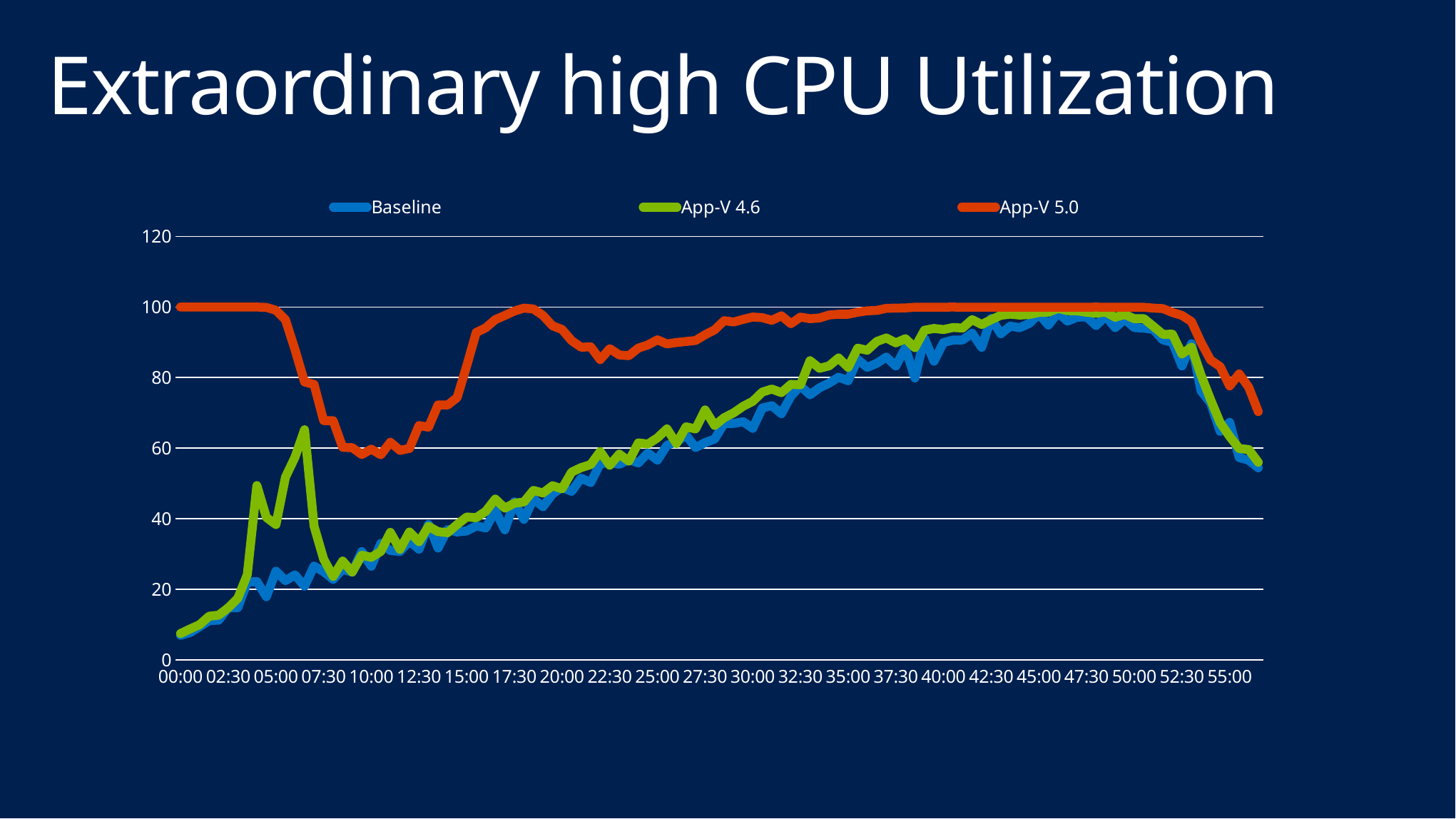
Is the value for App-V 5.0 at 10:00 greater or less than 80? less At 10:00, which is larger: App-V 5.0 or App-V 4.6? App-V 5.0 How many series does the legend list? 3 How many time labels are shown on the x axis? 23 Does the Baseline series rise or fall between 00:00 and 45:00? rise Which series is drawn in orange-red? App-V 5.0 What kind of chart is shown on the slide? Line chart Is the value for App-V 5.0 at 00:00 greater or less than 80? greater What is the title of the slide? Extraordinary high CPU Utilization Is the value for App-V 4.6 at 45:00 greater or less than 80? greater At 00:00, which is larger: App-V 5.0 or Baseline? App-V 5.0